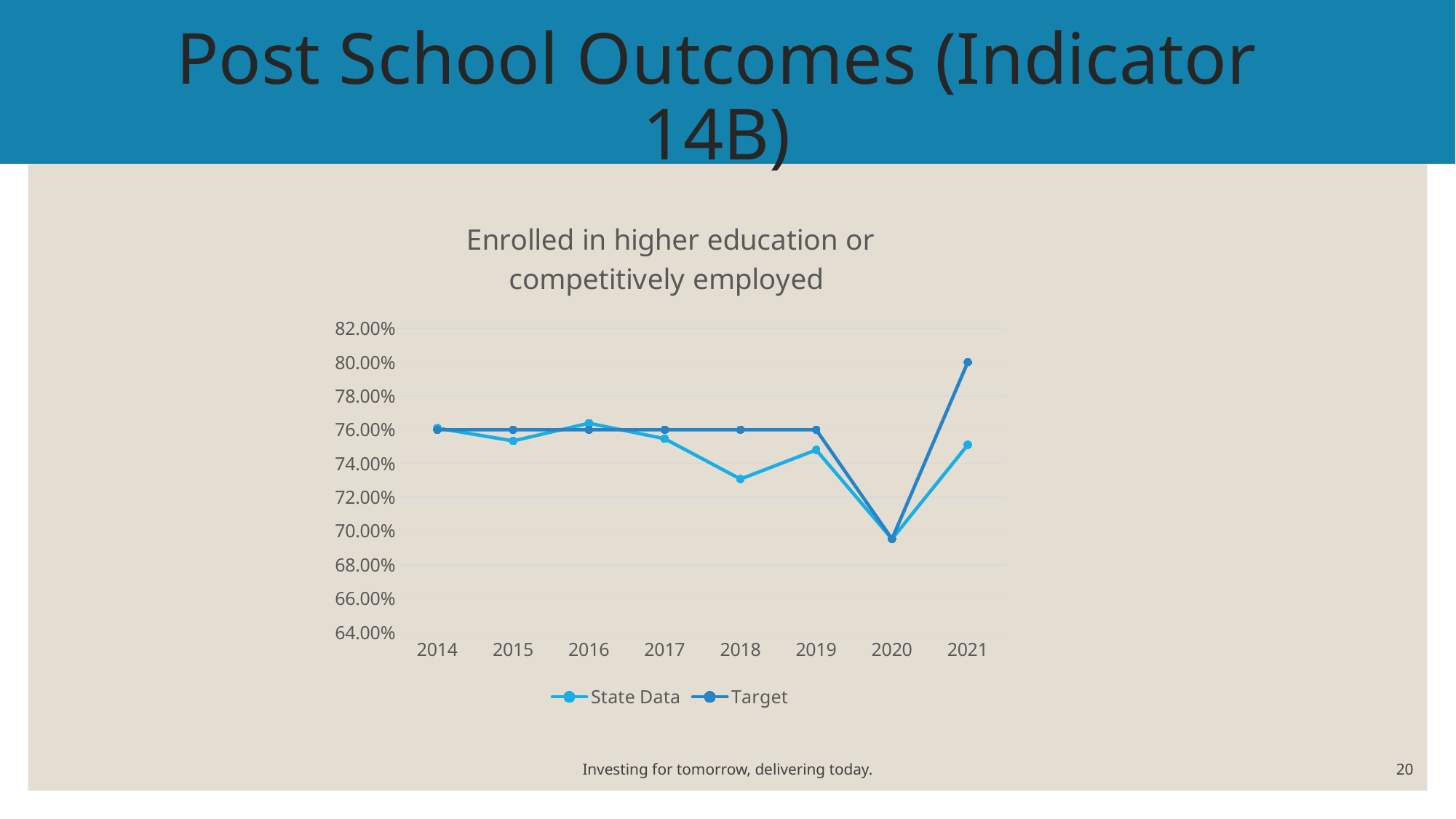
Does the Target line rise or fall from 2020 to 2021? rise What is the title of the chart? Enrolled in higher education or competitively employed In which year is the Target value highest? 2021 How many years are shown on the x axis? 8 In which year is the State Data value lowest? 2020 How many series does the legend list? 2 Which is larger in 2021, the State Data value or the Target value? Target What is the Target value for 2021? 80.00% Is the State Data value for 2020 greater or less than 72.00%? less What kind of chart is shown on the slide? line chart Is the State Data value for 2018 greater or less than 74.00%? less What is the Target value for 2014? 76.00%